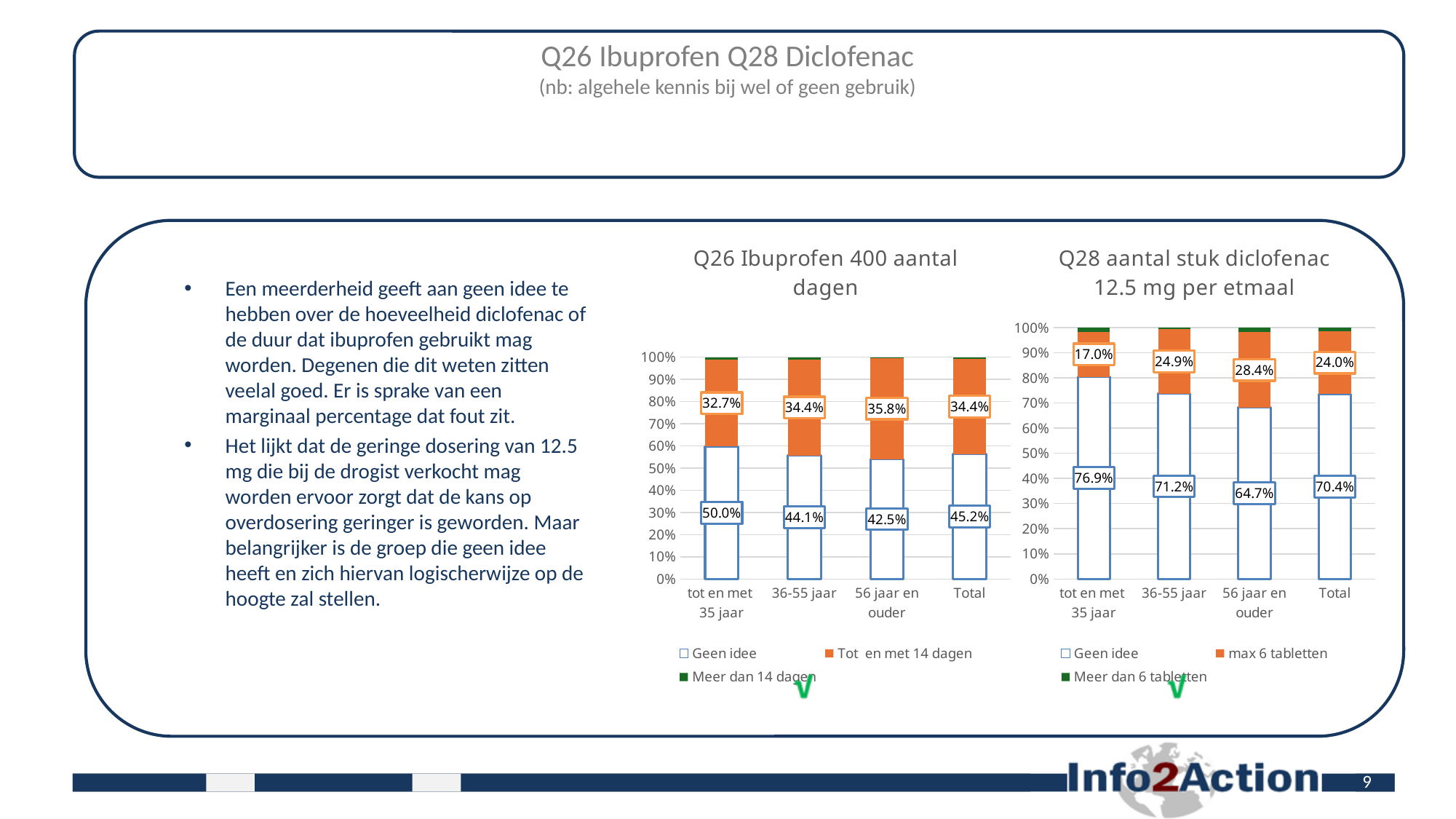
In the chart 'Q26 Ibuprofen 400 aantal dagen', which category has the highest 'Geen idee' value? tot en met 35 jaar In the chart 'Q26 Ibuprofen 400 aantal dagen', what is the 'Tot en met 14 dagen' value for '56 jaar en ouder'? 35.8% In the chart 'Q28 aantal stuk diclofenac 12.5 mg per etmaal', what is the 'Geen idee' value for 'Total'? 70.4% In the chart 'Q28 aantal stuk diclofenac 12.5 mg per etmaal', which category has the lowest 'Geen idee' value? 56 jaar en ouder How many series does the legend of the chart 'Q28 aantal stuk diclofenac 12.5 mg per etmaal' list? 3 In the chart 'Q28 aantal stuk diclofenac 12.5 mg per etmaal', what is the difference between the 'Geen idee' values for 'tot en met 35 jaar' and '56 jaar en ouder'? 12.2% In the chart 'Q28 aantal stuk diclofenac 12.5 mg per etmaal', is the 'max 6 tabletten' value for 'tot en met 35 jaar' greater or less than 20%? less How many categories are shown on the x axis of the chart 'Q26 Ibuprofen 400 aantal dagen'? 4 In the chart 'Q26 Ibuprofen 400 aantal dagen', what is the 'Geen idee' value for 'tot en met 35 jaar'? 50.0% In the chart 'Q28 aantal stuk diclofenac 12.5 mg per etmaal', what is the 'max 6 tabletten' value for '36-55 jaar'? 24.9% In the chart 'Q26 Ibuprofen 400 aantal dagen', is the 'Geen idee' value larger for '36-55 jaar' or for '56 jaar en ouder'? 36-55 jaar What kind of chart is 'Q26 Ibuprofen 400 aantal dagen'? Stacked bar chart